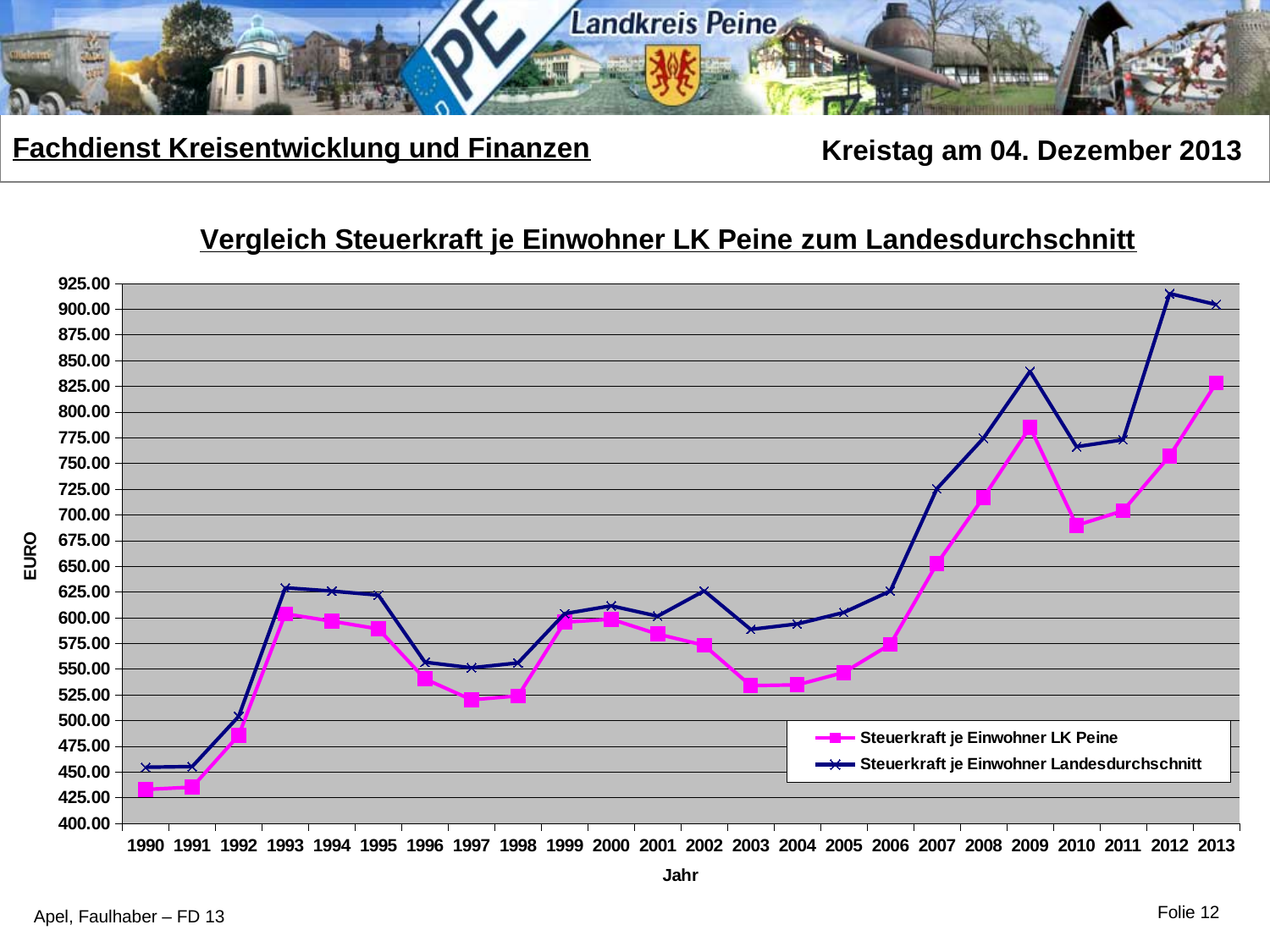
How many years are plotted along the x axis? 24 In which year is the value for Steuerkraft je Einwohner LK Peine highest? 2013 Does the value for Steuerkraft je Einwohner LK Peine rise or fall from 2010 to 2013? rise What is the label of the y axis? EURO What kind of chart is shown on the slide? Line chart In 2009, which series has the larger value: Steuerkraft je Einwohner LK Peine or Steuerkraft je Einwohner Landesdurchschnitt? Steuerkraft je Einwohner Landesdurchschnitt What is the title of the chart? Vergleich Steuerkraft je Einwohner LK Peine zum Landesdurchschnitt Is the value for Steuerkraft je Einwohner LK Peine in 2003 greater or less than 550.00? less How many series does the legend list? 2 Is the value for Steuerkraft je Einwohner LK Peine in 2013 greater or less than 800.00? greater In which year is the value for Steuerkraft je Einwohner Landesdurchschnitt highest? 2012 Is the value for Steuerkraft je Einwohner Landesdurchschnitt in 2012 greater or less than 900.00? greater